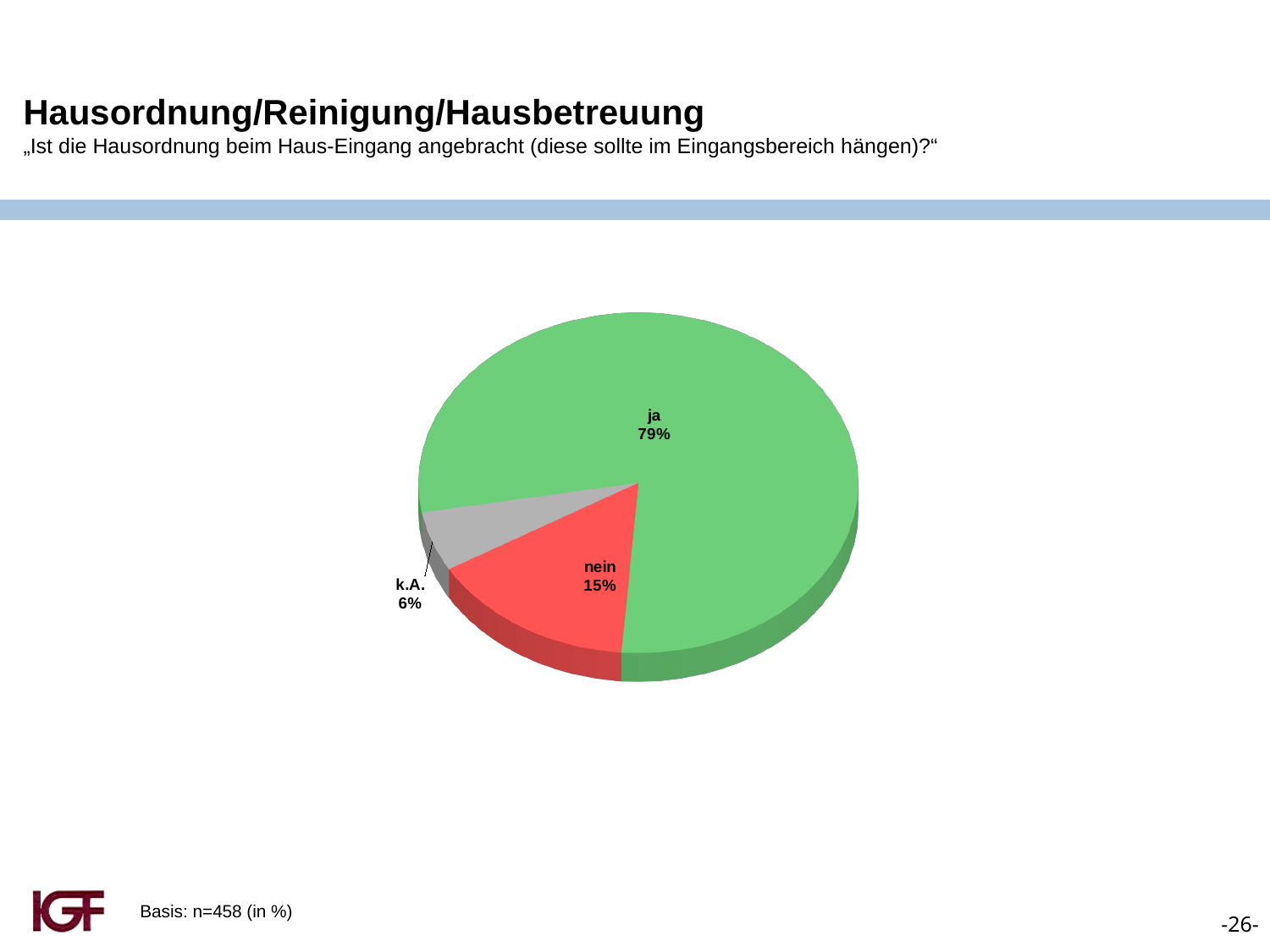
What share of the pie does "ja" have? 79% What is the difference in percentage points between "ja" and "nein"? 64 Which category has the largest slice of the pie? ja What kind of chart is shown on the slide? pie chart What colour is the "ja" slice of the pie? green What is the difference in percentage points between "nein" and "k.A."? 9 What is the sample size (Basis) stated on the slide? n=458 How many slices does the pie chart have? 3 Which is larger, the share for "nein" or the share for "k.A."? nein What share of the pie does "nein" have? 15% Which category has the smallest slice of the pie? k.A. What share of the pie does "k.A." have? 6%